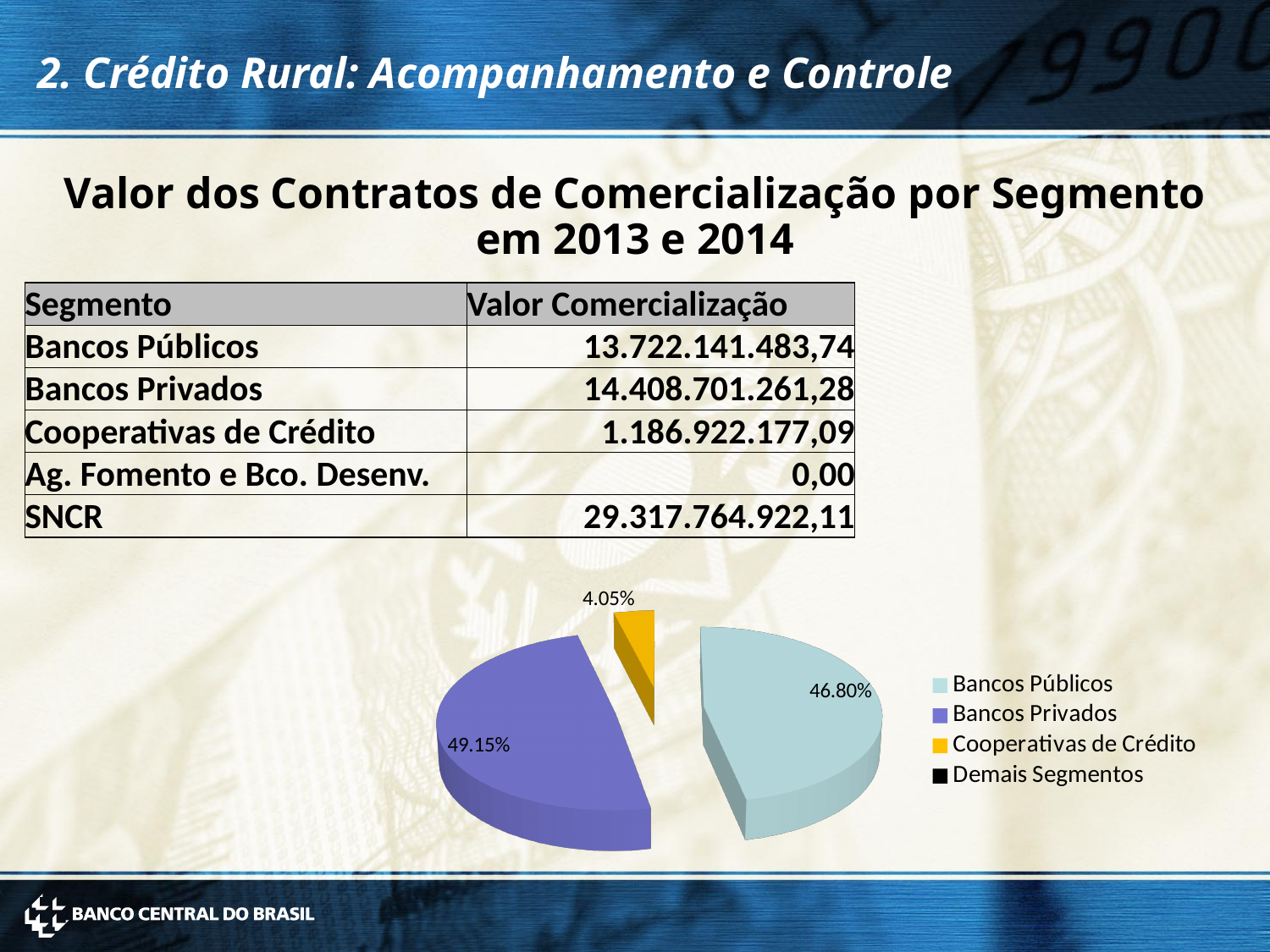
What share of the pie does Cooperativas de Crédito hold? 4.05% How many entries does the pie chart legend list? 4 Which segment with a visible slice has the smallest share of the pie? Cooperativas de Crédito What is the difference in percentage points between the Bancos Privados slice and the Bancos Públicos slice? 2.35 What share of the pie does Bancos Privados hold? 49.15% What share of the pie does Bancos Públicos hold? 46.80% What colour is the Cooperativas de Crédito slice in the pie chart? yellow Which segment has the largest slice of the pie? Bancos Privados Which slice is larger, Bancos Públicos or Cooperativas de Crédito? Bancos Públicos Which legend entry is shown in black? Demais Segmentos How many slices with percentage labels are visible in the pie chart? 3 What kind of chart is shown on the slide? pie chart